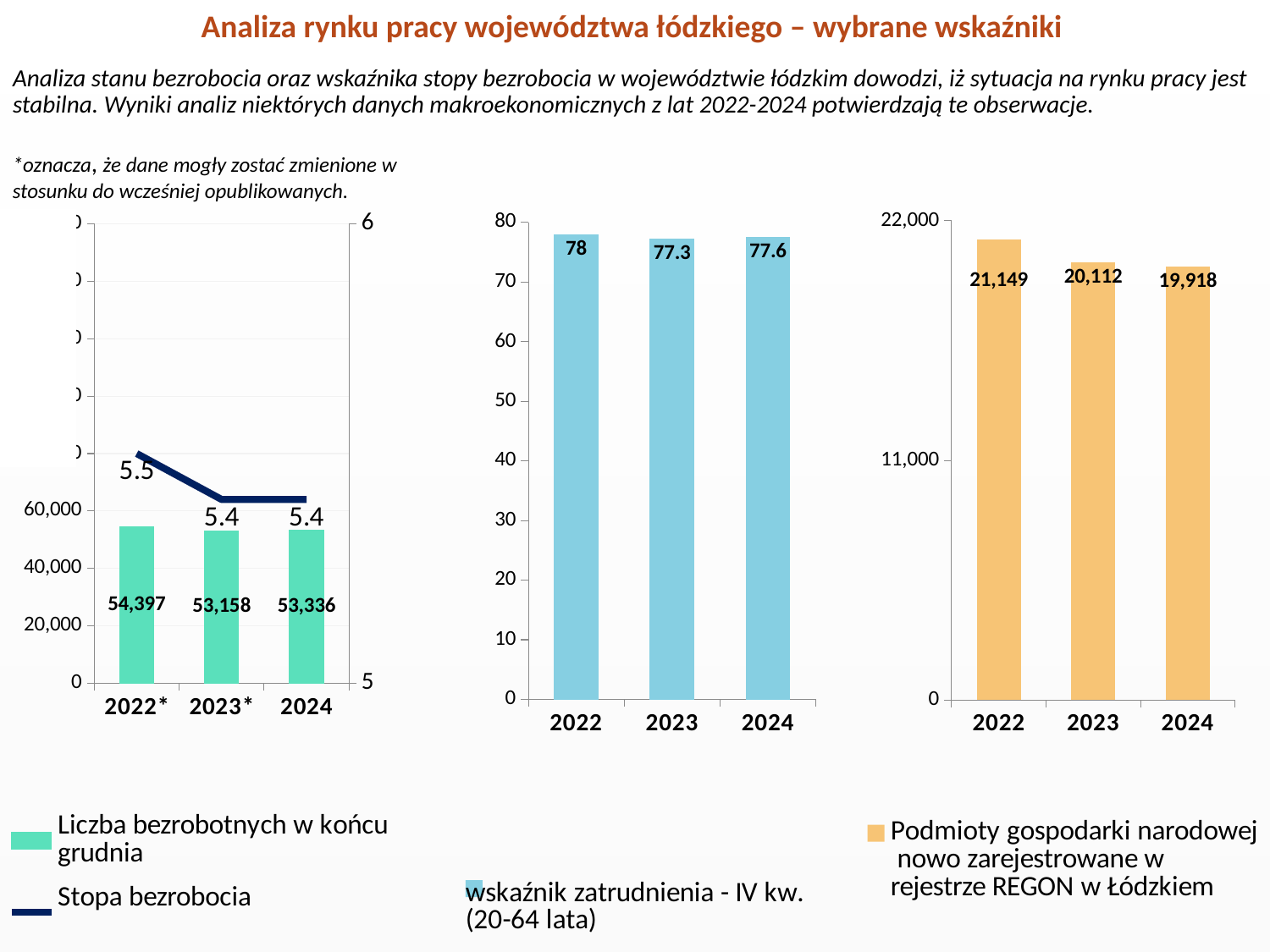
In the left chart, what is the value of 'Liczba bezrobotnych w końcu grudnia' for 2022*? 54,397 In the left chart, which year has the lowest 'Liczba bezrobotnych w końcu grudnia'? 2023* In the left chart, what is the 'Stopa bezrobocia' value for 2024? 5.4 In the right chart, what is the difference between the values for 2022 and 2023? 1,037 In the left chart, what is the difference between the 'Liczba bezrobotnych w końcu grudnia' values for 2022* and 2024? 1,061 In the middle chart, which year has the highest value? 2022 In the right chart, what is the value for 2024? 19,918 In the middle chart, is the value for 2024 greater or less than 70? greater What kind of chart is the middle chart? bar chart How many series does the legend of the left chart list? 2 In the middle chart, what is the 'wskaźnik zatrudnienia - IV kw. (20-64 lata)' value for 2023? 77.3 In the right chart, do the values rise or fall from 2022 to 2024? fall